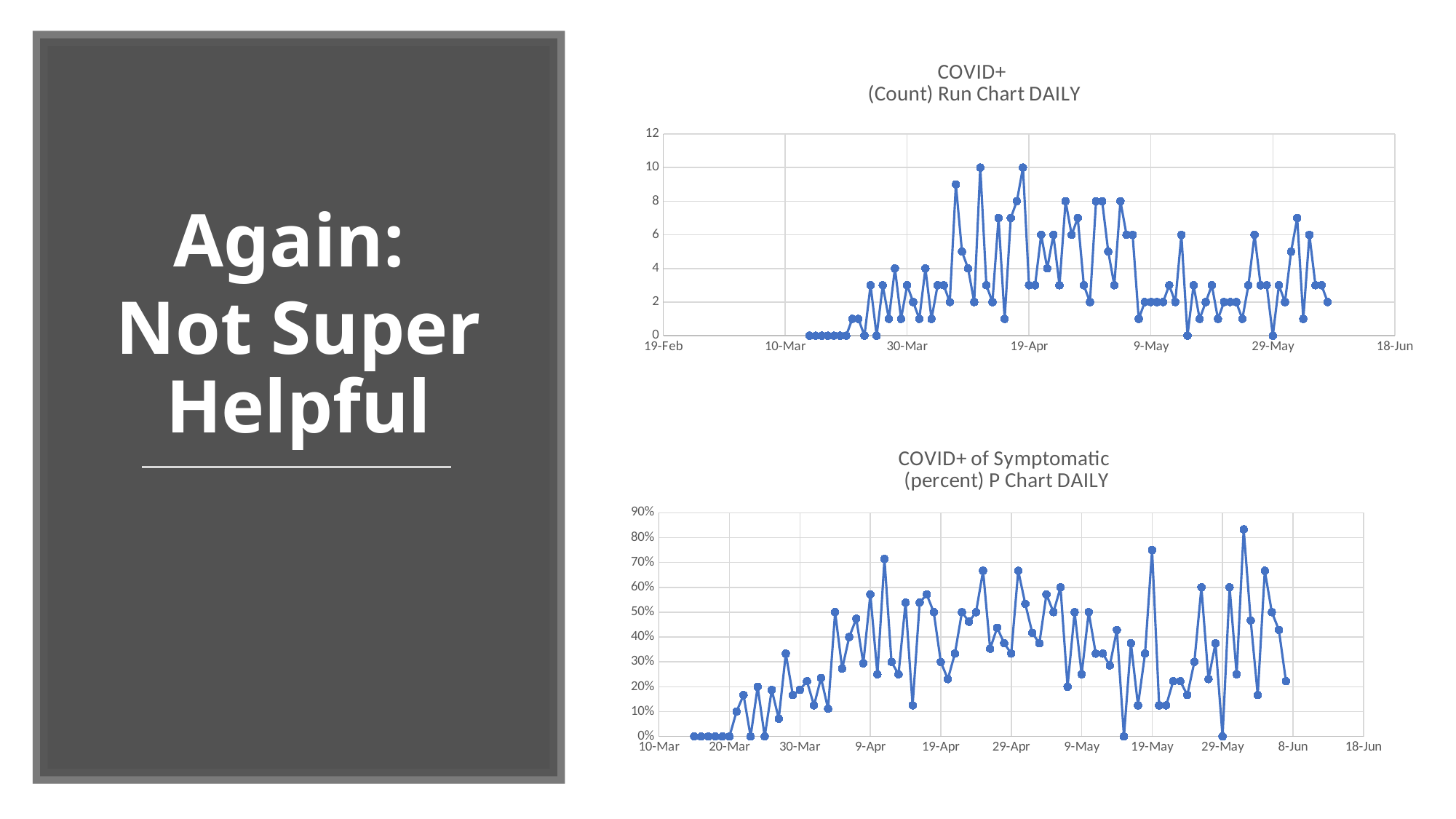
In the top chart, 'COVID+ (Count) Run Chart DAILY', what is the lowest value reached by the plotted line? 0 What is the title of the top chart on the slide? COVID+ (Count) Run Chart DAILY What kind of chart is the bottom chart, 'COVID+ of Symptomatic (percent) P Chart DAILY'? line chart In the top chart, 'COVID+ (Count) Run Chart DAILY', what is the highest value reached by the plotted line? 10 What kind of chart is the top chart, 'COVID+ (Count) Run Chart DAILY'? line chart In the bottom chart, 'COVID+ of Symptomatic (percent) P Chart DAILY', is the highest plotted value greater or less than 80%? greater What is the title of the bottom chart on the slide? COVID+ of Symptomatic (percent) P Chart DAILY In the top chart, 'COVID+ (Count) Run Chart DAILY', do the plotted values generally rise or fall between 10-Mar and 19-Apr? rise In the top chart, 'COVID+ (Count) Run Chart DAILY', is the highest plotted value greater or less than 8? greater In the bottom chart, 'COVID+ of Symptomatic (percent) P Chart DAILY', do the plotted values generally rise or fall between 20-Mar and 9-Apr? rise In the bottom chart, 'COVID+ of Symptomatic (percent) P Chart DAILY', what is the lowest value reached by the plotted line? 0%